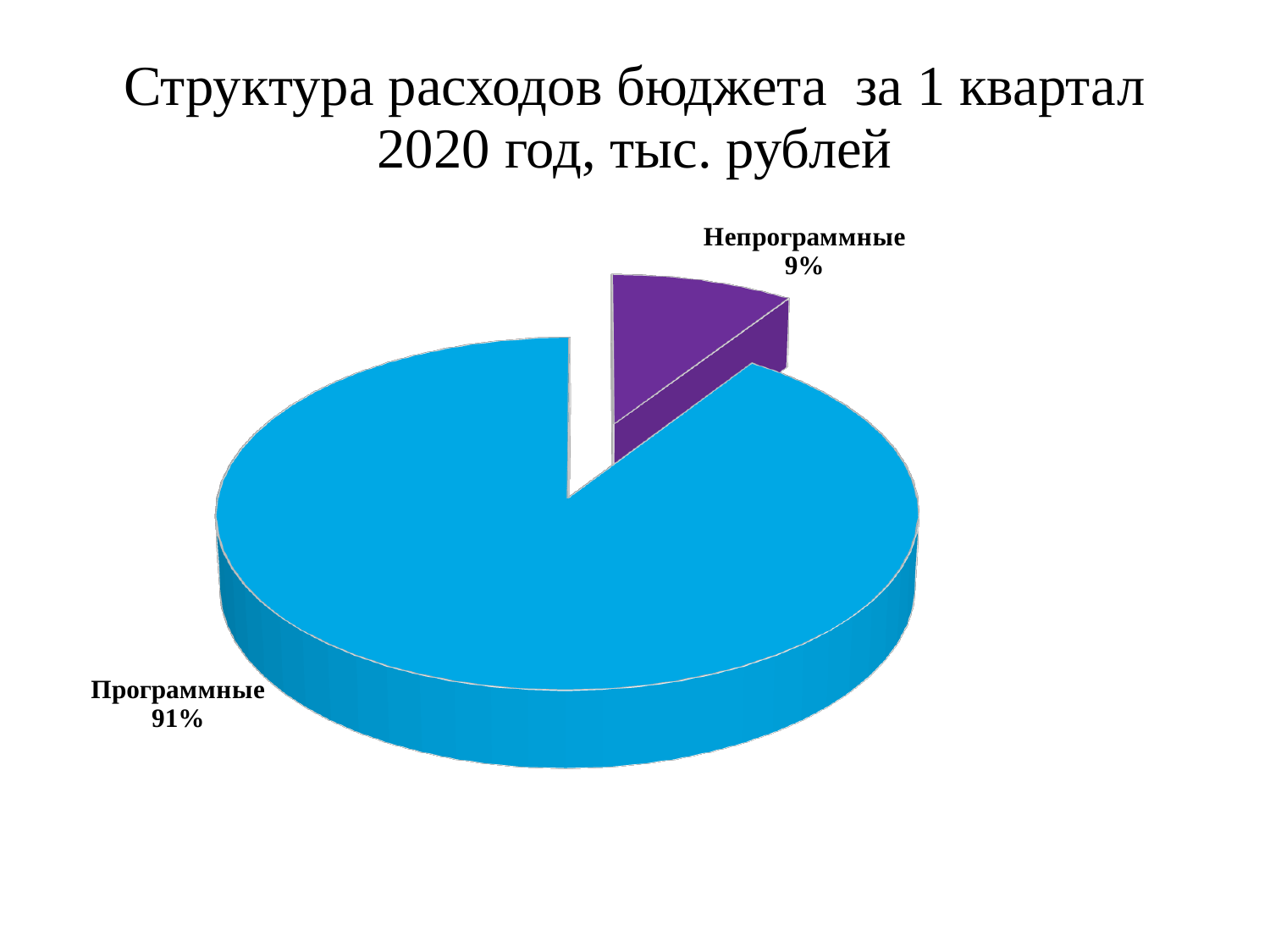
Which category has the smallest slice of the pie? Непрограммные What kind of chart is shown on the slide? Pie chart What is the title of the slide? Структура расходов бюджета за 1 квартал 2020 год, тыс. рублей What share of the pie does the Программные slice represent? 91% How many slices does the pie chart have? 2 Which slice is larger, Программные or Непрограммные? Программные Which category has the largest slice of the pie? Программные What is the difference in percentage points between the Программные and Непрограммные slices? 82 What share of the pie does the Непрограммные slice represent? 9% What colour is the Непрограммные slice? Purple